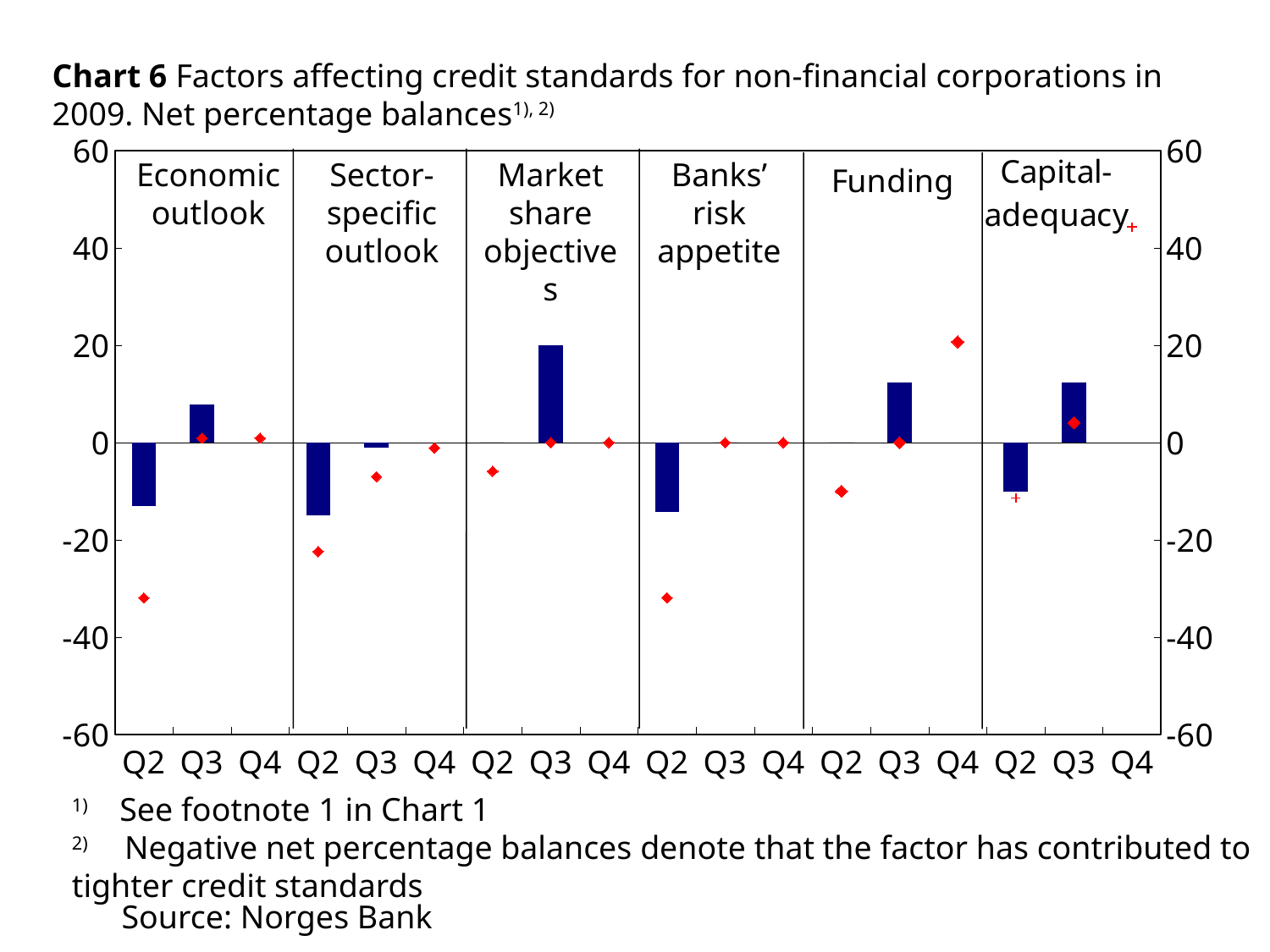
What kind of chart is shown on the slide? bar chart Is the Q2 bar for Economic outlook greater or less than 0? less Which is larger, the Q3 bar for Market share objectives or the Q3 bar for Funding? Market share objectives How many factors (panels) are shown along the x axis of the chart? 6 Which factor has the tallest positive bar in the chart? Market share objectives Is the Q4 marker for Capital adequacy greater or less than 40? greater Is the Q3 bar for Market share objectives greater or less than 10? greater How many quarters are shown for each factor in the chart? 3 What is the source given for the chart? Norges Bank Do the bars for Economic outlook rise or fall from Q2 to Q3? rise